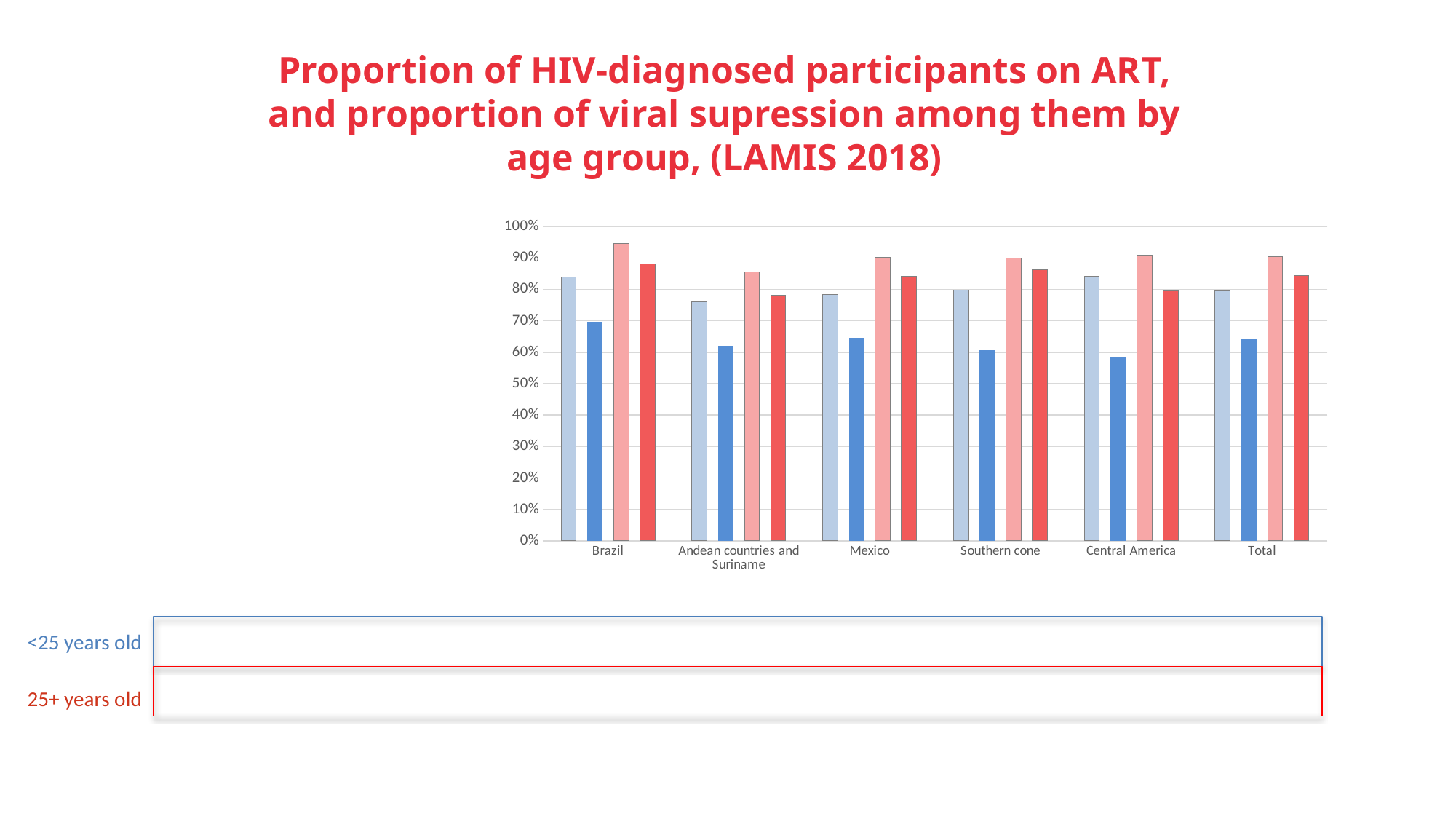
Which is larger, the dark blue bar for Brazil or the dark blue bar for Central America? Brazil Is the value of the dark blue bar for Central America greater or less than 60%? less How many categories are shown along the x axis of the chart? 6 Is the value of the light pink bar for Brazil greater or less than 90%? greater What kind of chart is shown on the slide? bar chart Is the value of the light blue bar for Central America greater or less than 80%? greater Which category has the lowest dark blue bar? Central America Which category has the highest dark blue bar? Brazil Which category has the highest light pink bar? Brazil